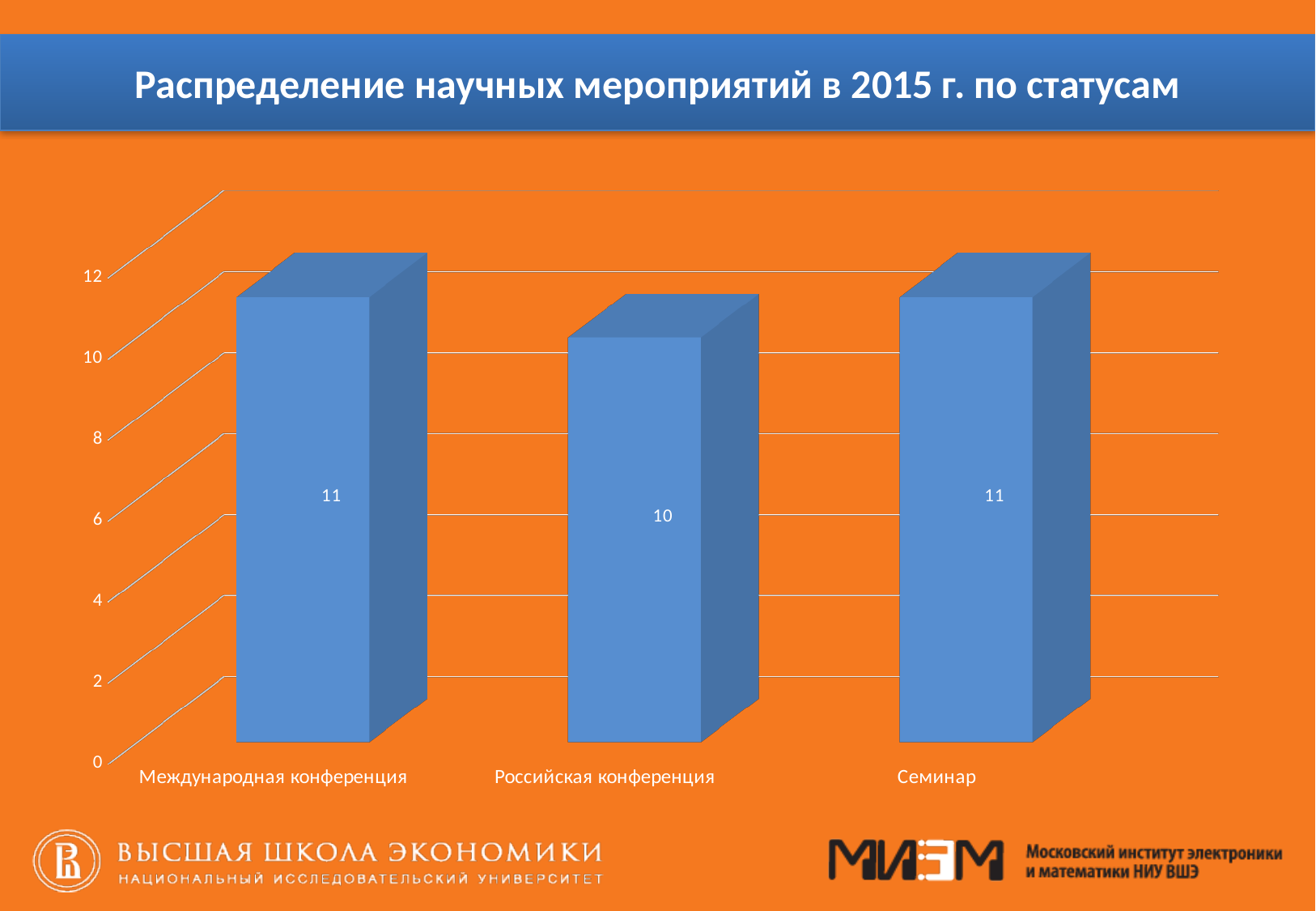
What is the value for Семинар? 11 What is the value for Международная конференция? 11 What kind of chart is shown on the slide? bar chart What is the difference between the values for Международная конференция and Российская конференция? 1 Is the value for Российская конференция greater or less than 12? less Which category has the lowest value? Российская конференция Which is larger, the value for Семинар or the value for Российская конференция? Семинар What is the title of the chart? Распределение научных мероприятий в 2015 г. по статусам Is the value for Семинар greater or less than 8? greater How many categories are shown on the x axis? 3 What is the value for Российская конференция? 10 What is the total of the values for all three categories? 32